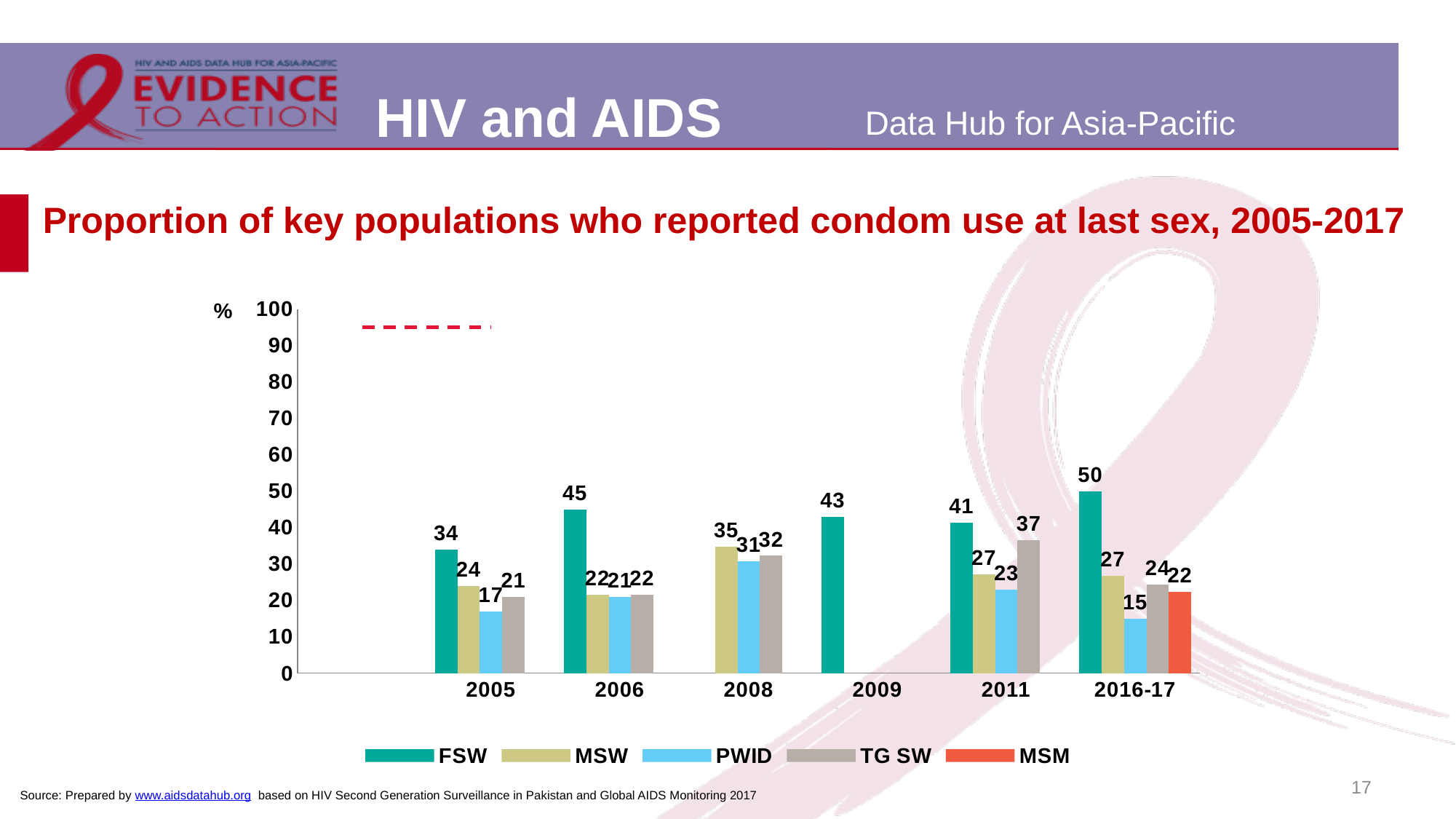
In which year is the PWID value lowest? 2016-17 What is the value for PWID in 2005? 17 How many series does the legend list? 5 What is the value for MSW in 2008? 35 What is the value for TG SW in 2011? 37 How many year categories are shown on the x axis? 6 In 2011, which is larger: the TG SW value or the MSW value? TG SW In which year is the FSW value highest? 2016-17 What is the difference between the FSW value in 2016-17 and the FSW value in 2005? 16 What is the value for MSM in 2016-17? 22 What is the value for FSW in 2016-17? 50 What kind of chart is shown on the slide? Bar chart